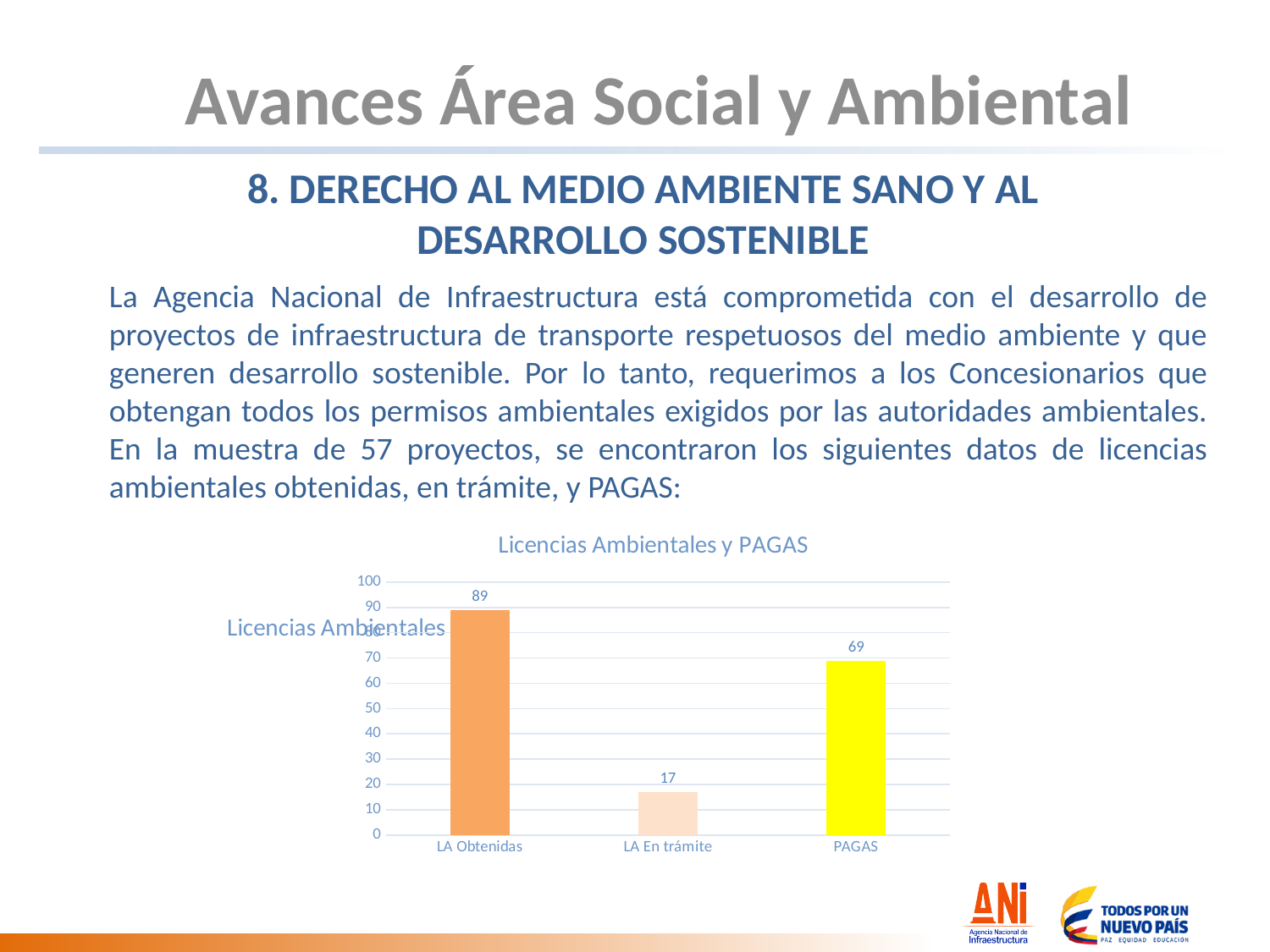
What is the value for LA Obtenidas? 89 Which category has the highest value? LA Obtenidas What is the title of the chart? Licencias Ambientales y PAGAS What is the value for PAGAS? 69 Which category has the lowest value? LA En trámite How many categories are shown on the x axis? 3 Is the value for PAGAS greater or less than 60? greater What is the difference between the values for PAGAS and LA En trámite? 52 What is the value for LA En trámite? 17 What kind of chart is shown on the slide? bar chart Which is larger, the value for LA En trámite or the value for PAGAS? PAGAS What is the difference between the values for LA Obtenidas and PAGAS? 20